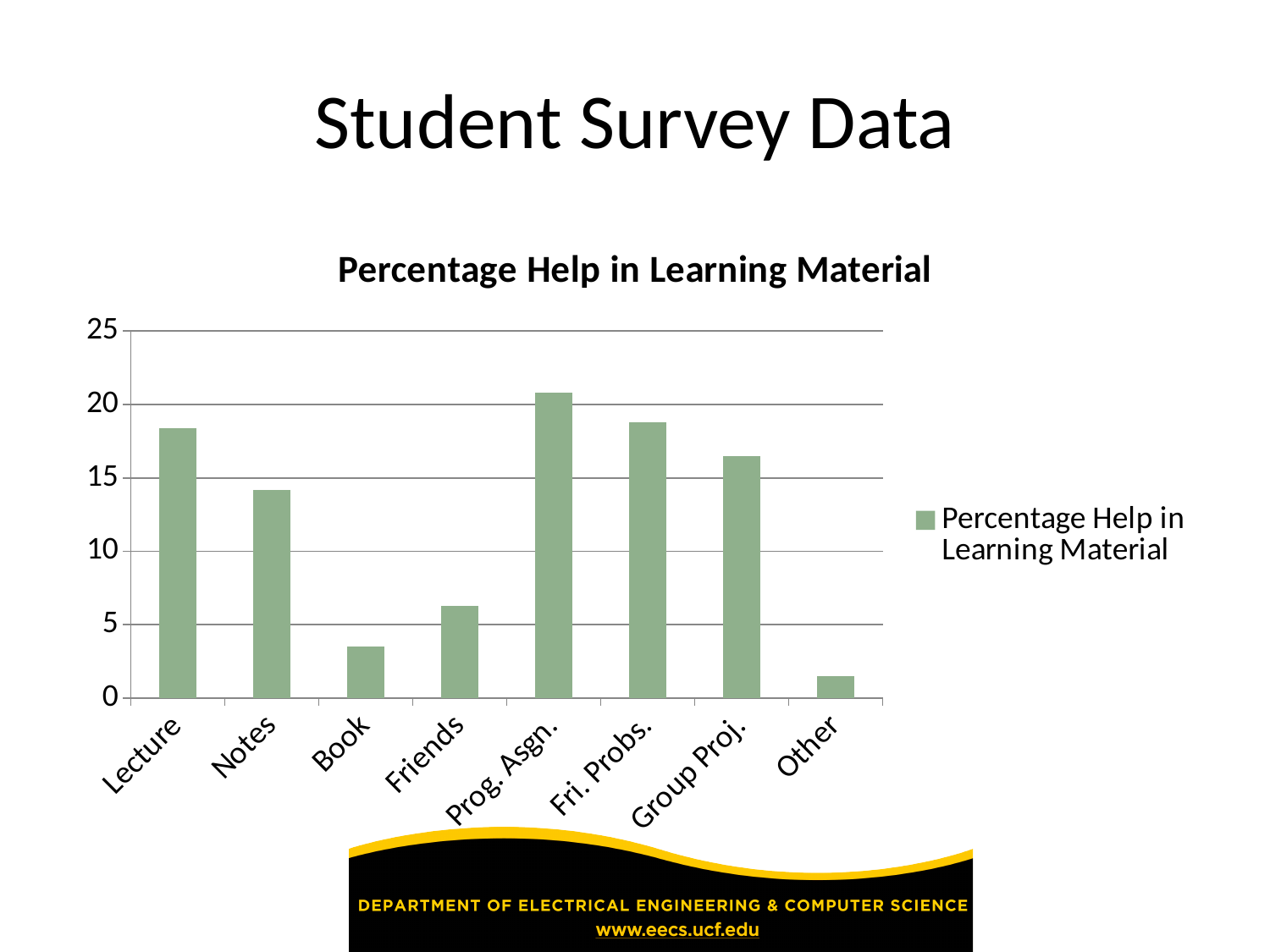
Which has a larger value, Book or Friends? Friends How many series does the legend list? 1 Is the value for Prog. Asgn. greater or less than 20? greater Which category has the lowest value in the chart? Other Which has a larger value, Notes or Group Proj.? Group Proj. Is the value for Book greater or less than 5? less What type of chart is shown on the slide? bar chart What is the title of the chart? Percentage Help in Learning Material How many categories are shown on the x axis of the chart? 8 Is the value for Friends greater or less than 5? greater Which category has the highest value in the chart? Prog. Asgn.